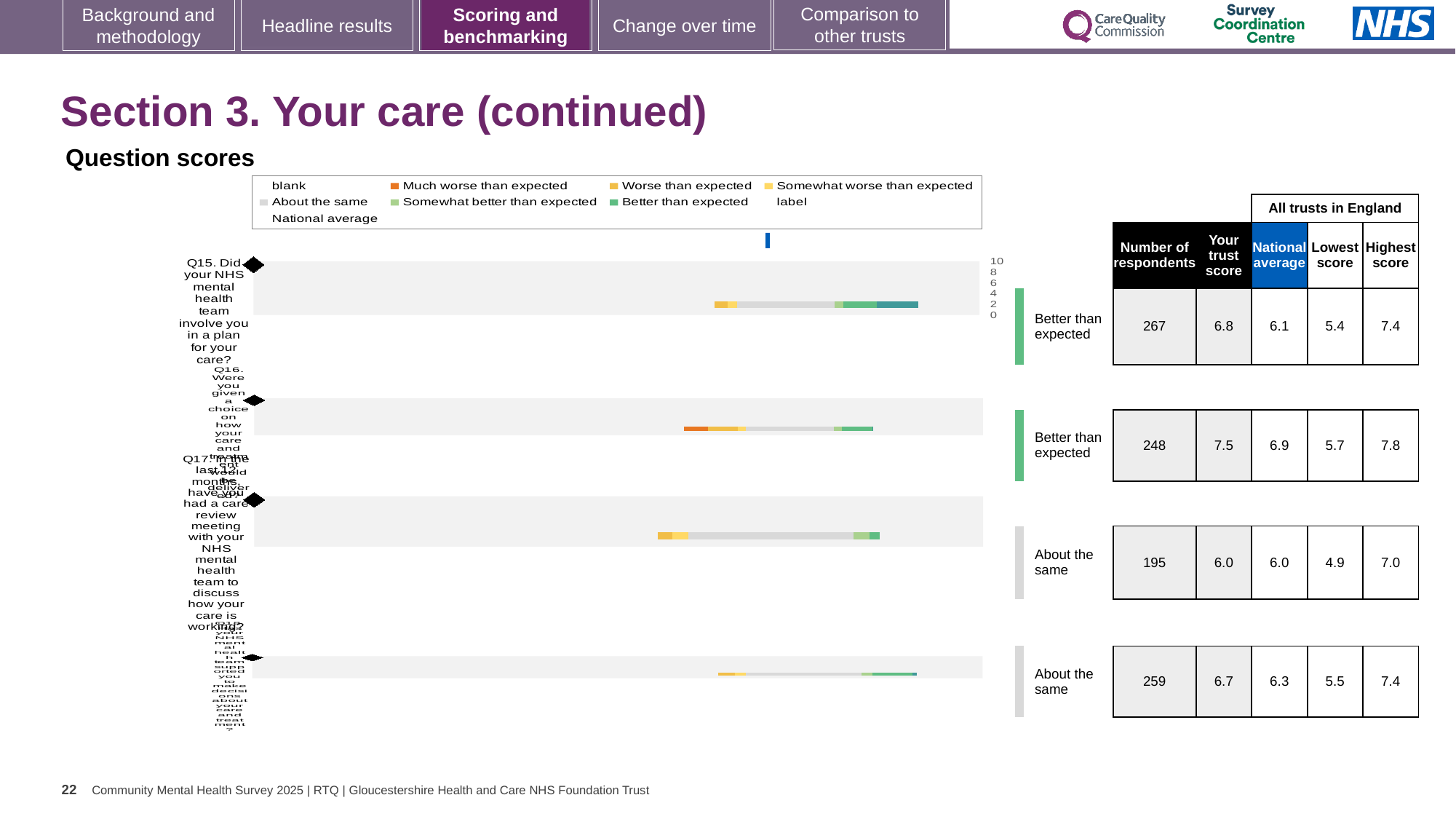
Is the trust score for Q15 higher or lower than the national average for Q15? higher What is the trust score for Q15 (involving you in a plan for your care)? 6.8 Which question row has the lowest trust score? Q17 What is the highest score among all trusts in England for the fourth question row (Q18)? 7.4 Which question row has the most respondents? Q15 What is the national average score for Q15? 6.1 What kind of chart is used to show the question scores on this slide? bar chart Which question row has the highest trust score? Q16 What is the difference between the trust score and the national average for Q16? 0.6 How many questions (rows) are plotted in the question scores chart? 4 What benchmark category is shown for Q17 (care review meeting)? About the same How many respondents answered Q17 (care review meeting in the last 12 months)? 195